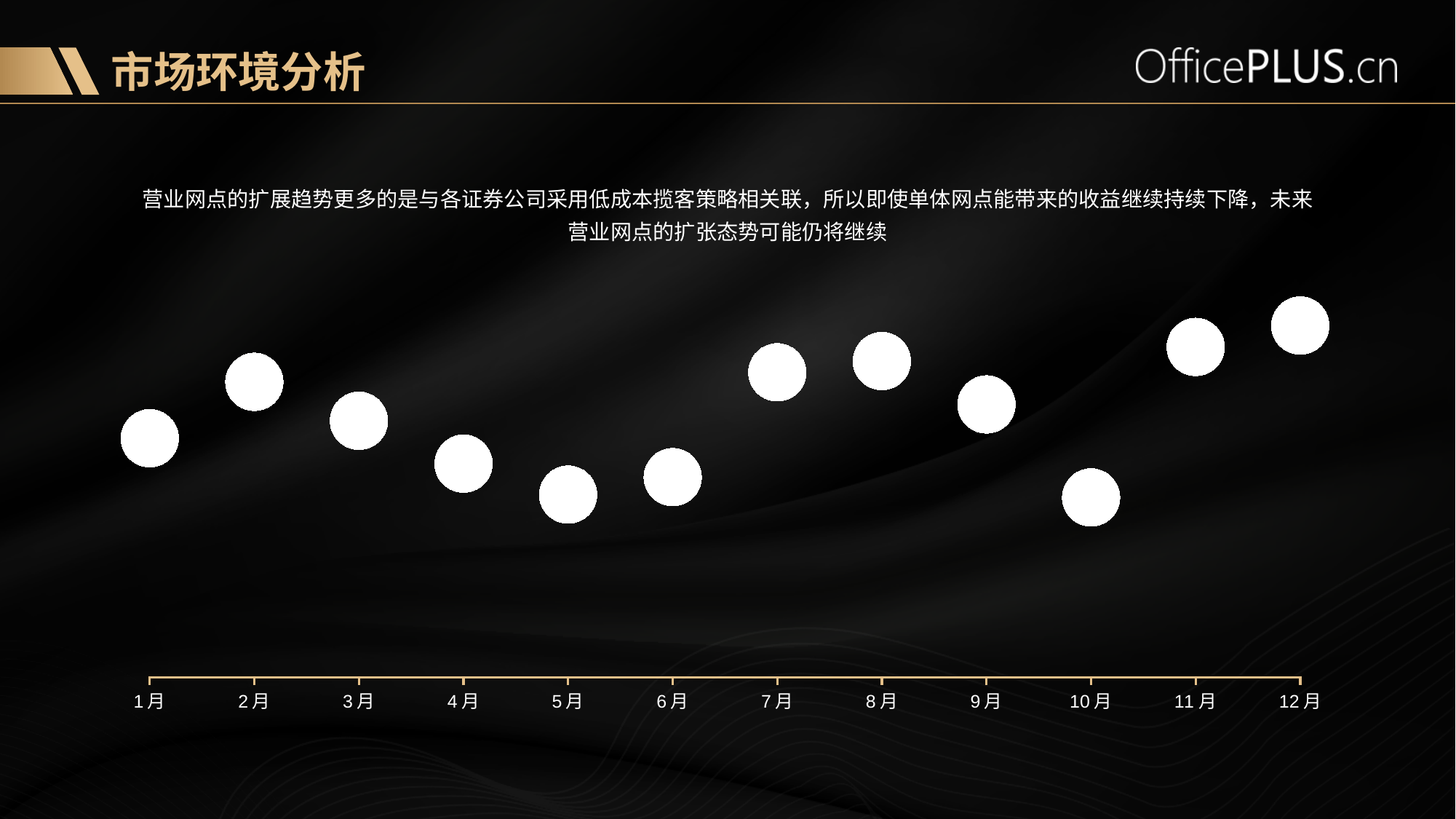
Do the values rise or fall from 10月 to 12月? rise Which is higher on the chart, the value for 3月 or the value for 5月? 3月 What is the title of the slide containing the chart? 市场环境分析 How many data points are plotted on the chart? 12 Which month has the highest value on the chart? 12月 What is the first category label on the x axis of the chart? 1月 Which is higher on the chart, the value for 6月 or the value for 11月? 11月 Which is higher on the chart, the value for 1月 or the value for 2月? 2月 Do the values rise or fall from 2月 to 5月? fall What kind of chart is shown on the slide? scatter chart